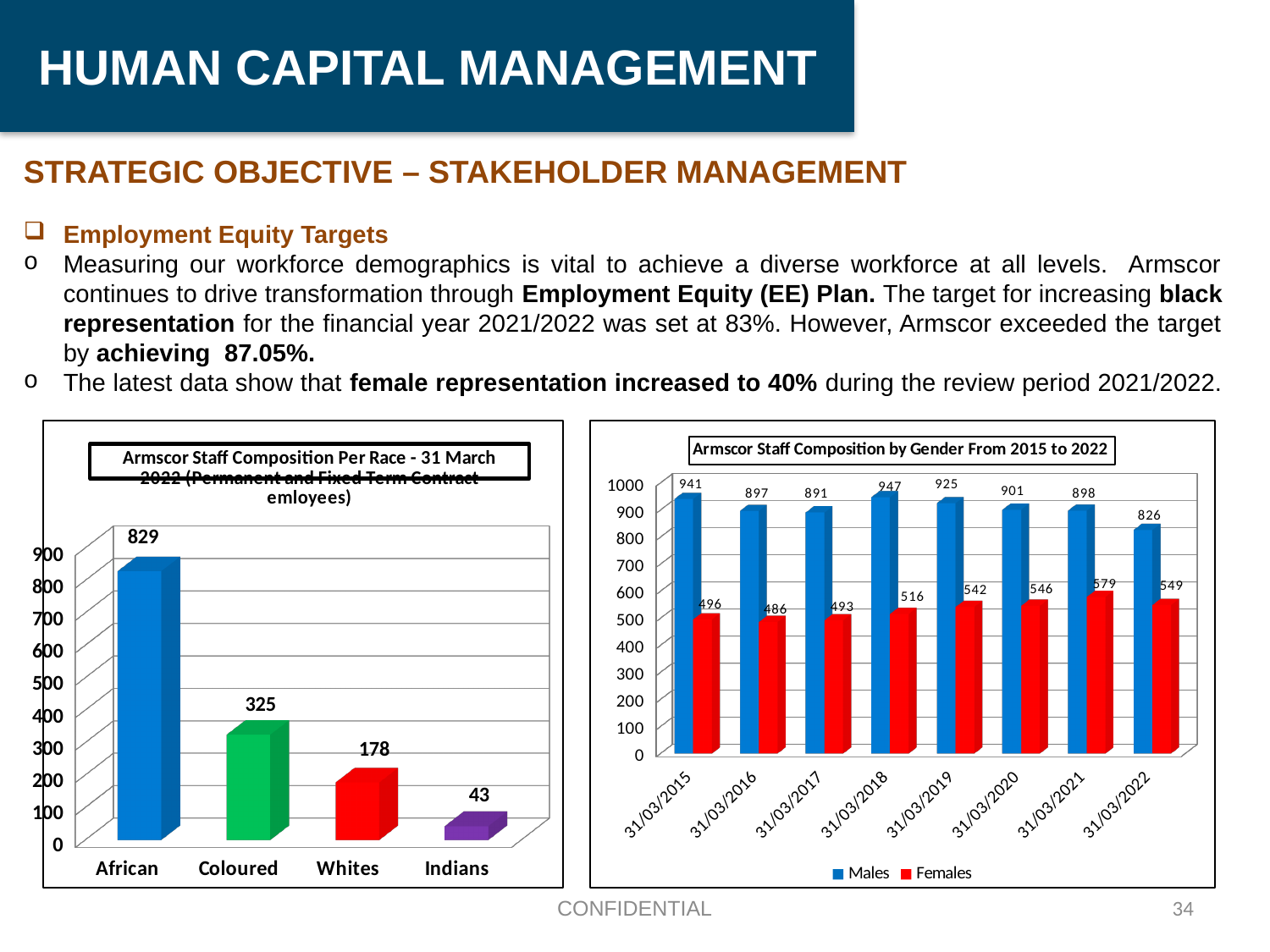
What kind of chart is the 'Armscor Staff Composition Per Race' chart on the left? Bar chart In the 'Armscor Staff Composition by Gender' chart on the right, what is the difference between Males and Females on 31/03/2022? 277 In the 'Armscor Staff Composition by Gender' chart on the right, what is the Males value for 31/03/2018? 947 In the 'Armscor Staff Composition by Gender' chart on the right, which date has the highest Females value? 31/03/2021 In the 'Armscor Staff Composition by Gender' chart on the right, how many series does the legend list? 2 In the 'Armscor Staff Composition Per Race' chart on the left, which category has the lowest value? Indians In the 'Armscor Staff Composition by Gender' chart on the right, which colour represents Females? Red In the 'Armscor Staff Composition by Gender' chart on the right, what is the Females value for 31/03/2021? 579 In the 'Armscor Staff Composition Per Race' chart on the left, what is the value for African? 829 In the 'Armscor Staff Composition Per Race' chart on the left, how many categories are shown? 4 In the 'Armscor Staff Composition Per Race' chart on the left, what is the difference between the Coloured and Whites values? 147 In the 'Armscor Staff Composition by Gender' chart on the right, which date has the lowest Males value? 31/03/2022